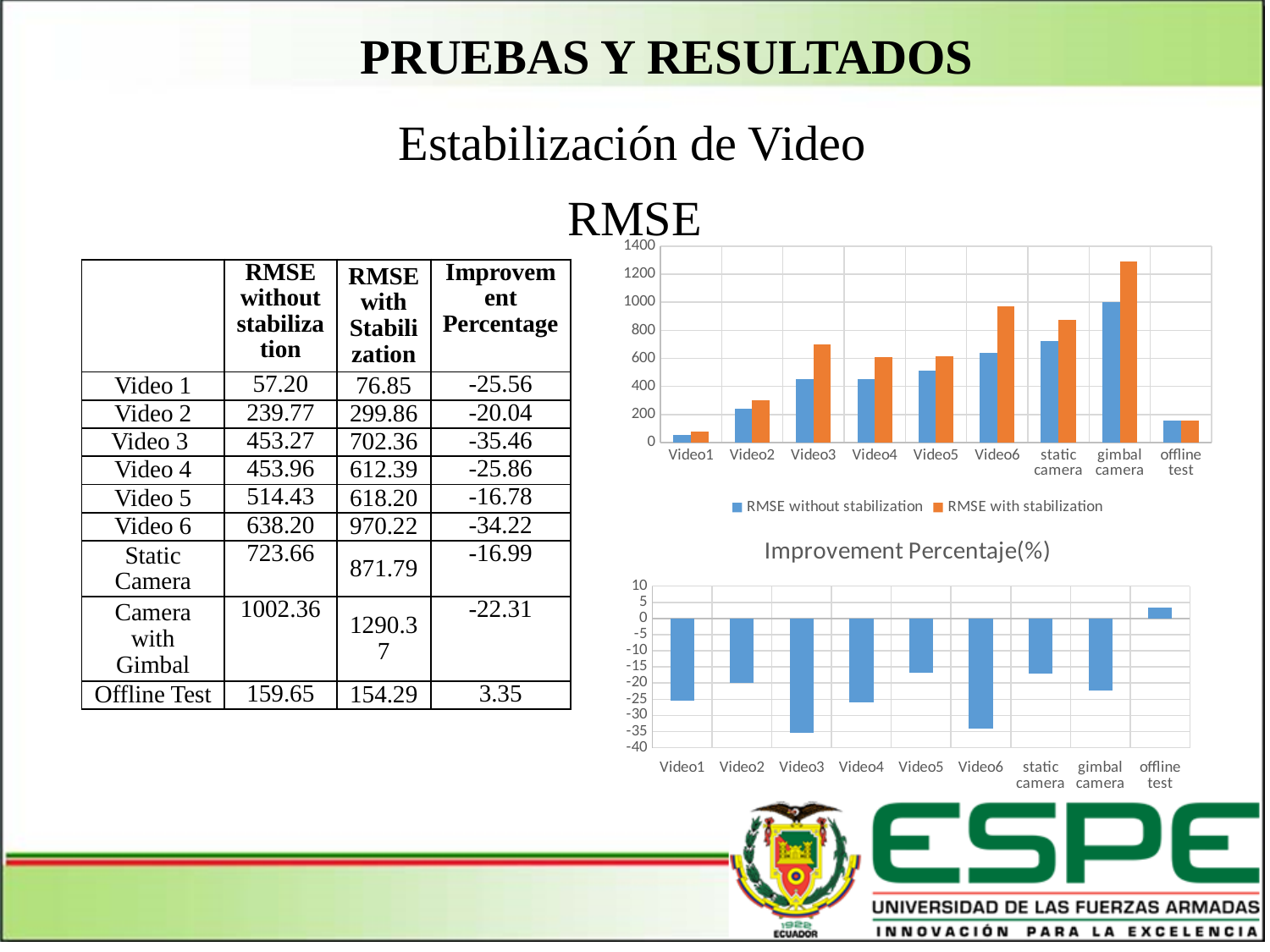
In the RMSE chart, which category has the highest RMSE with stabilization? gimbal camera In the RMSE chart, is the RMSE with stabilization for static camera greater or less than 800? greater In the RMSE chart, which category has the lowest RMSE without stabilization? Video1 In the RMSE chart, what is the RMSE with stabilization for Video3? 702.36 In the Improvement Percentaje(%) chart, what is the value for Video6? -34.22 In the RMSE chart, is the RMSE with stabilization for gimbal camera greater or less than 1200? greater How many series does the legend of the RMSE chart list? 2 In the Improvement Percentaje(%) chart, which category is the only one with a positive value? offline test In the RMSE chart, for Video3, which is larger: RMSE without stabilization or RMSE with stabilization? RMSE with stabilization In the Improvement Percentaje(%) chart, is the value for Video1 greater or less than -20? less What kind of chart is the RMSE chart at the top right? bar chart How many categories are shown on the x axis of the RMSE chart? 9